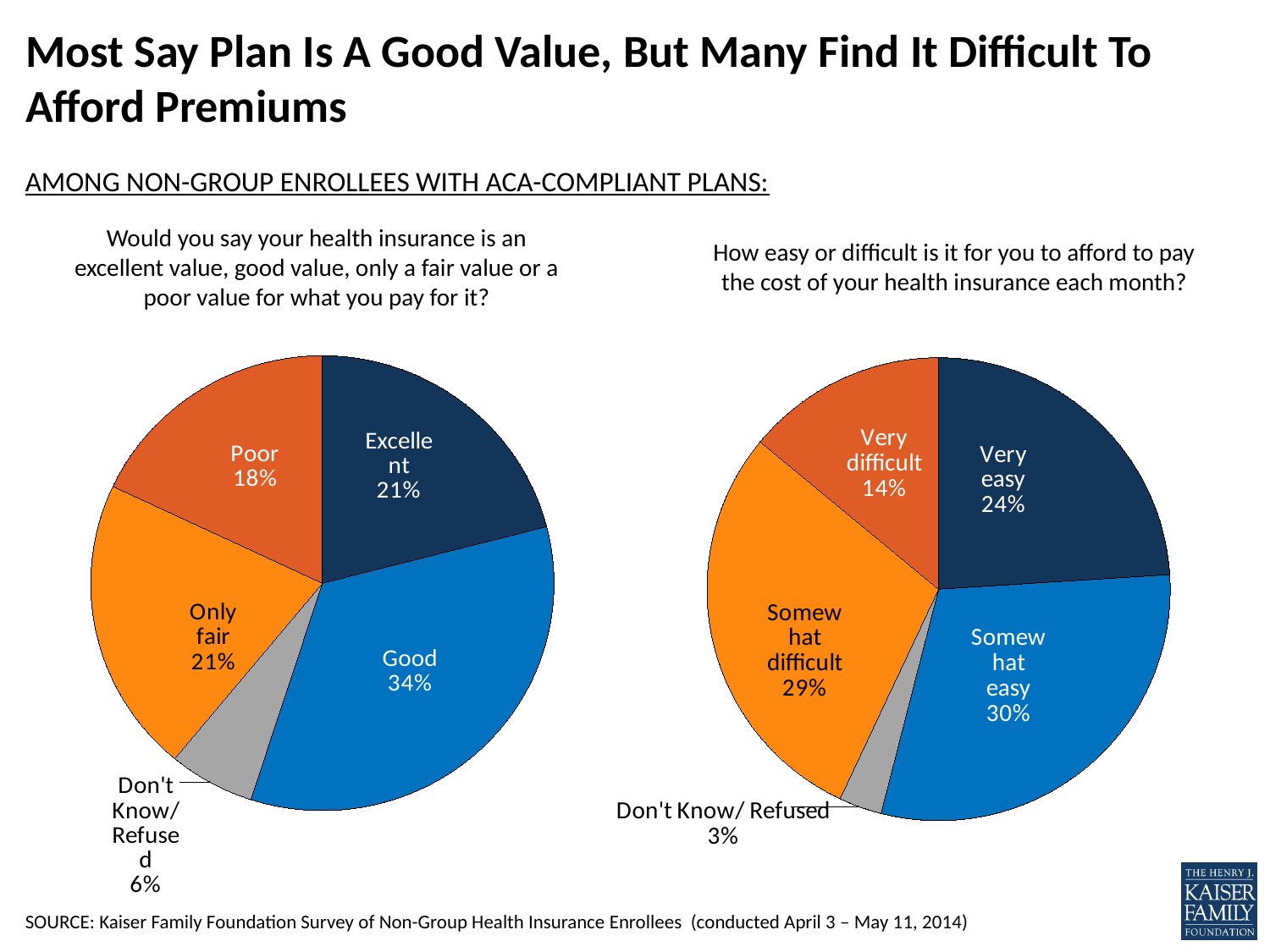
In the left pie chart (value of health insurance), which response has the largest share? Good In the left pie chart (value of health insurance), what share of enrollees answered Don't Know/Refused? 6% In the right pie chart (ease of affording premiums), which is larger: Somewhat easy or Somewhat difficult? Somewhat easy In the right pie chart (ease of affording premiums), what percentage say it is very difficult to afford the cost of their health insurance each month? 14% In the left pie chart (value of health insurance), which two responses both have a share of 21%? Excellent and Only fair What type of chart is used on the right side of the slide for the question about affording premiums? Pie chart In the left pie chart (value of health insurance), what is the difference in percentage points between Good and Poor? 16 In the left pie chart (value of health insurance), what percentage of enrollees say their plan is a good value? 34% How many slices does the left pie chart (value of health insurance) have? 5 In the right pie chart (ease of affording premiums), what is the combined share of Very easy and Somewhat easy? 54% In the right pie chart (ease of affording premiums), which response has the smallest share? Don't Know/ Refused What colour is the Good slice in the left pie chart? Blue